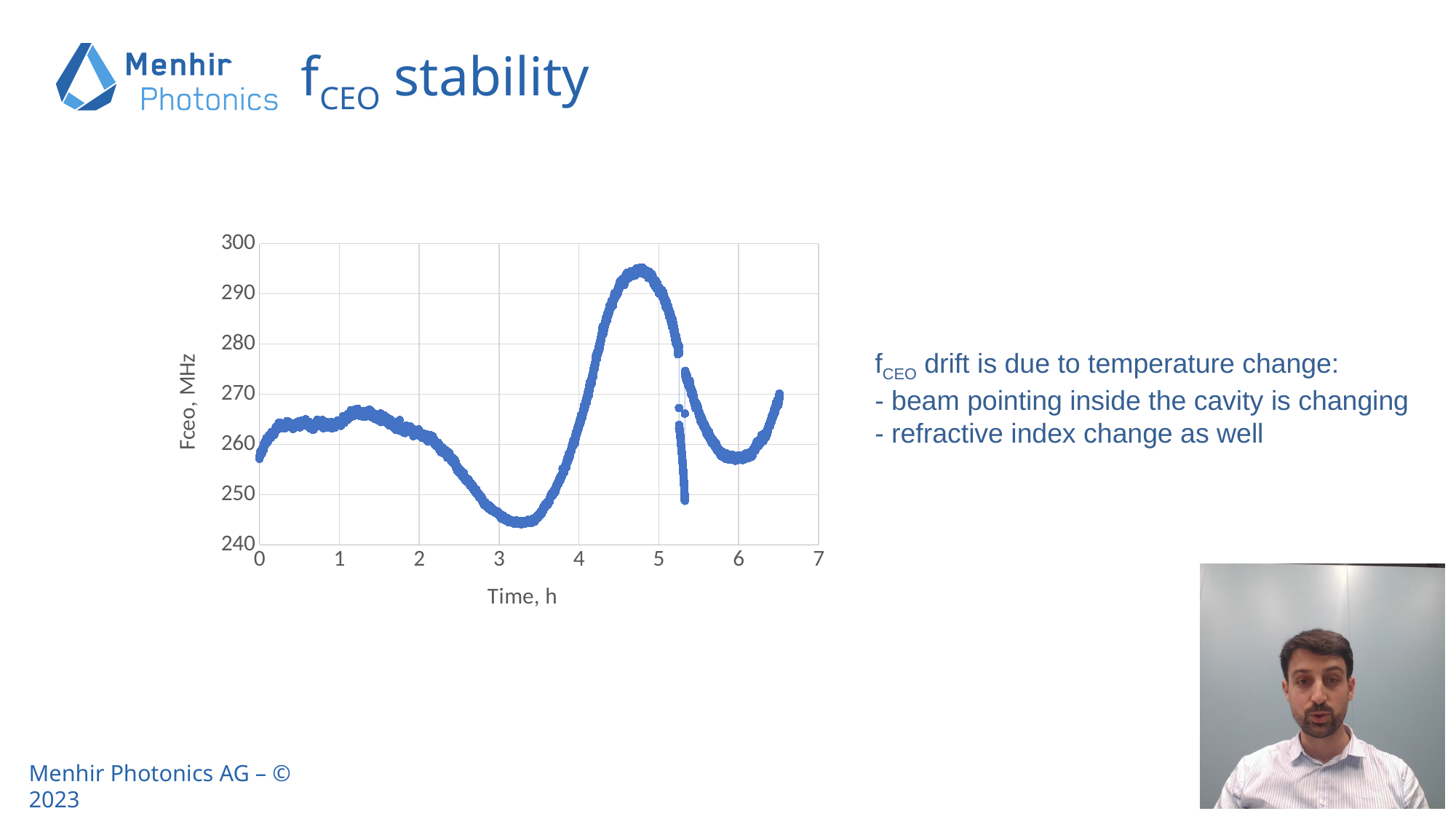
Is the value of Fceo at time 4 h greater or less than 260 MHz? greater What kind of chart is shown on the slide? scatter chart Between which two x-axis ticks does Fceo reach its highest value? between 4 and 5 h Between which two x-axis ticks does Fceo reach its lowest value? between 3 and 4 h Which is larger, the Fceo value near 4.75 h or the Fceo value near 1.2 h? the value near 4.75 h Is the value of Fceo at time 6 h greater or less than 260 MHz? less Is the value of Fceo at time 0 h greater or less than 260 MHz? less What is the label of the x axis of the chart? Time, h What is the label of the y axis of the chart? Fceo, MHz Do the Fceo values rise or fall between 2 h and 3 h? fall